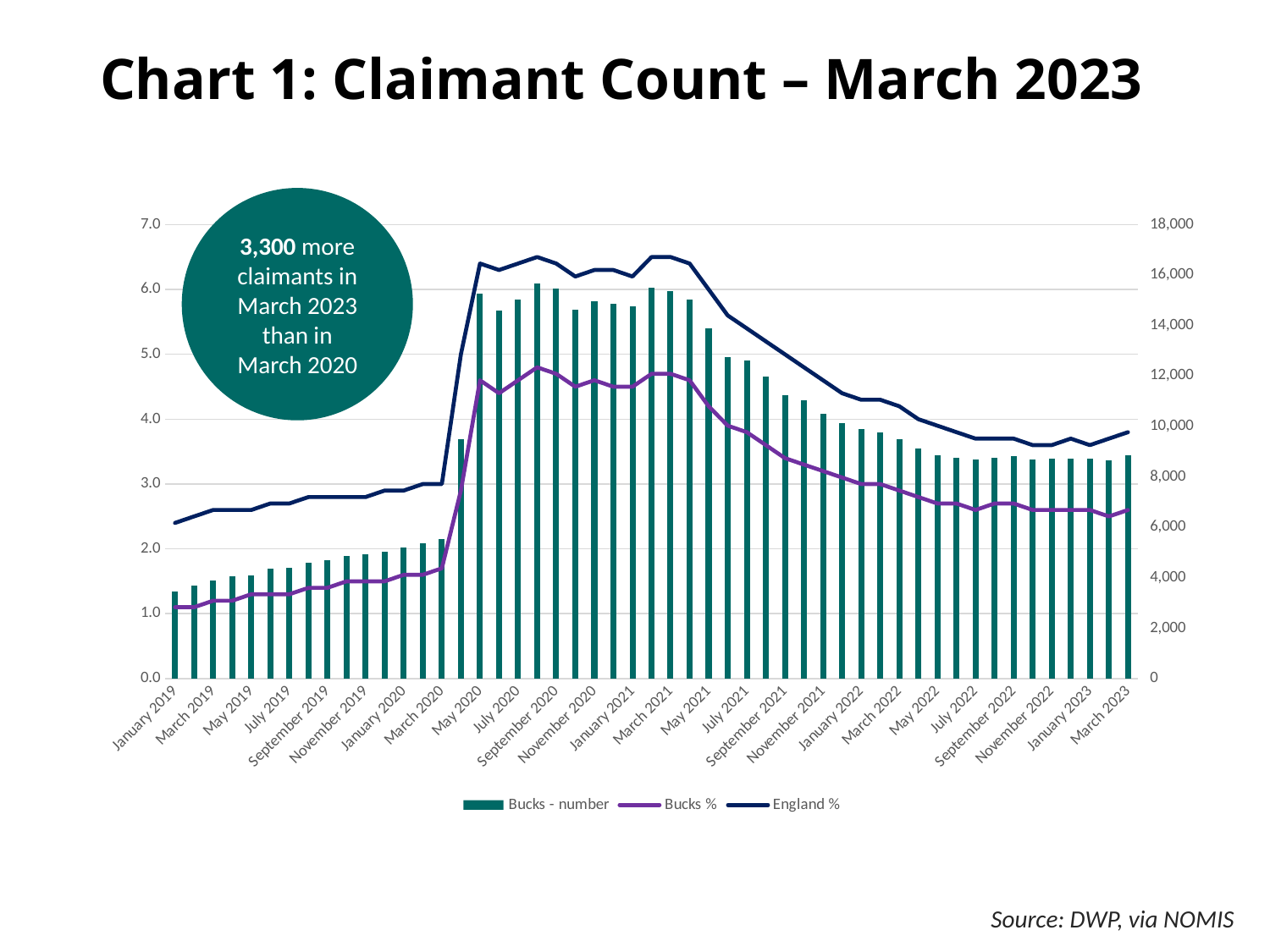
Is the England % value for May 2020 greater or less than 6.0? greater Is the England % value for January 2019 greater or less than 3.0? less Is the Bucks - number value for March 2020 greater or less than 6,000? less Do the Bucks - number bars rise or fall from May 2020 to March 2023? fall According to the callout, how many more claimants were there in March 2023 than in March 2020? 3,300 How many series does the legend list? 3 Which month has the lowest Bucks - number value? January 2019 What kind of chart is shown on the slide? A combined bar and line chart Which series is drawn as bars? Bucks - number In March 2023, which is higher: Bucks % or England %? England %